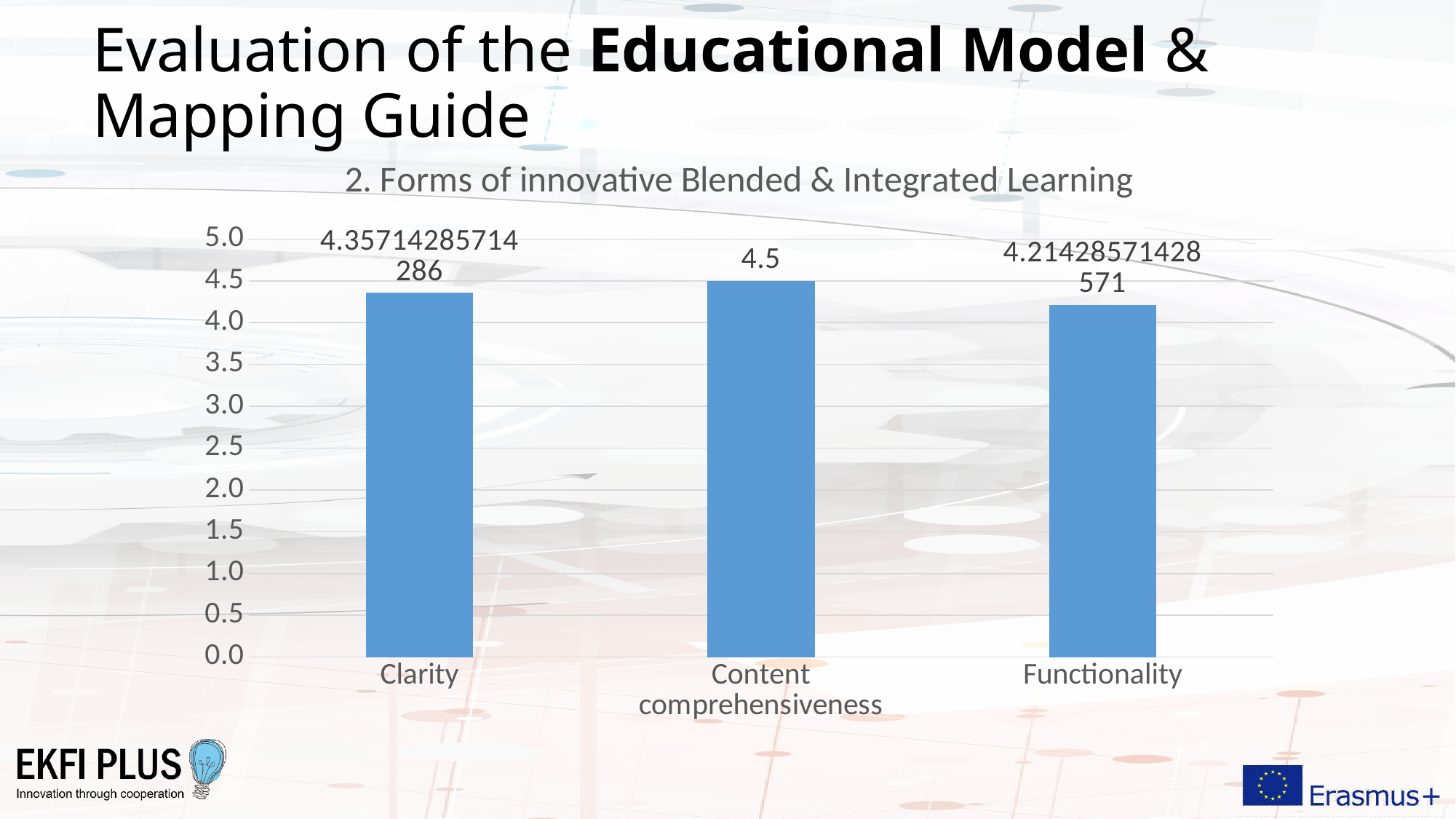
Is the value for Functionality greater or less than 4.0? greater What is the value for Content comprehensiveness? 4.5 Which is larger, the value for Clarity or the value for Functionality? Clarity Is the value for Clarity greater or less than 4.5? less What is the value for Functionality? 4.21428571428571 What is the maximum value shown on the vertical axis? 5.0 What is the value for Clarity? 4.35714285714286 Which category has the lowest value? Functionality Which category has the highest value? Content comprehensiveness What kind of chart is shown on the slide? bar chart What is the title of the chart? 2. Forms of innovative Blended & Integrated Learning How many categories are shown in the chart? 3